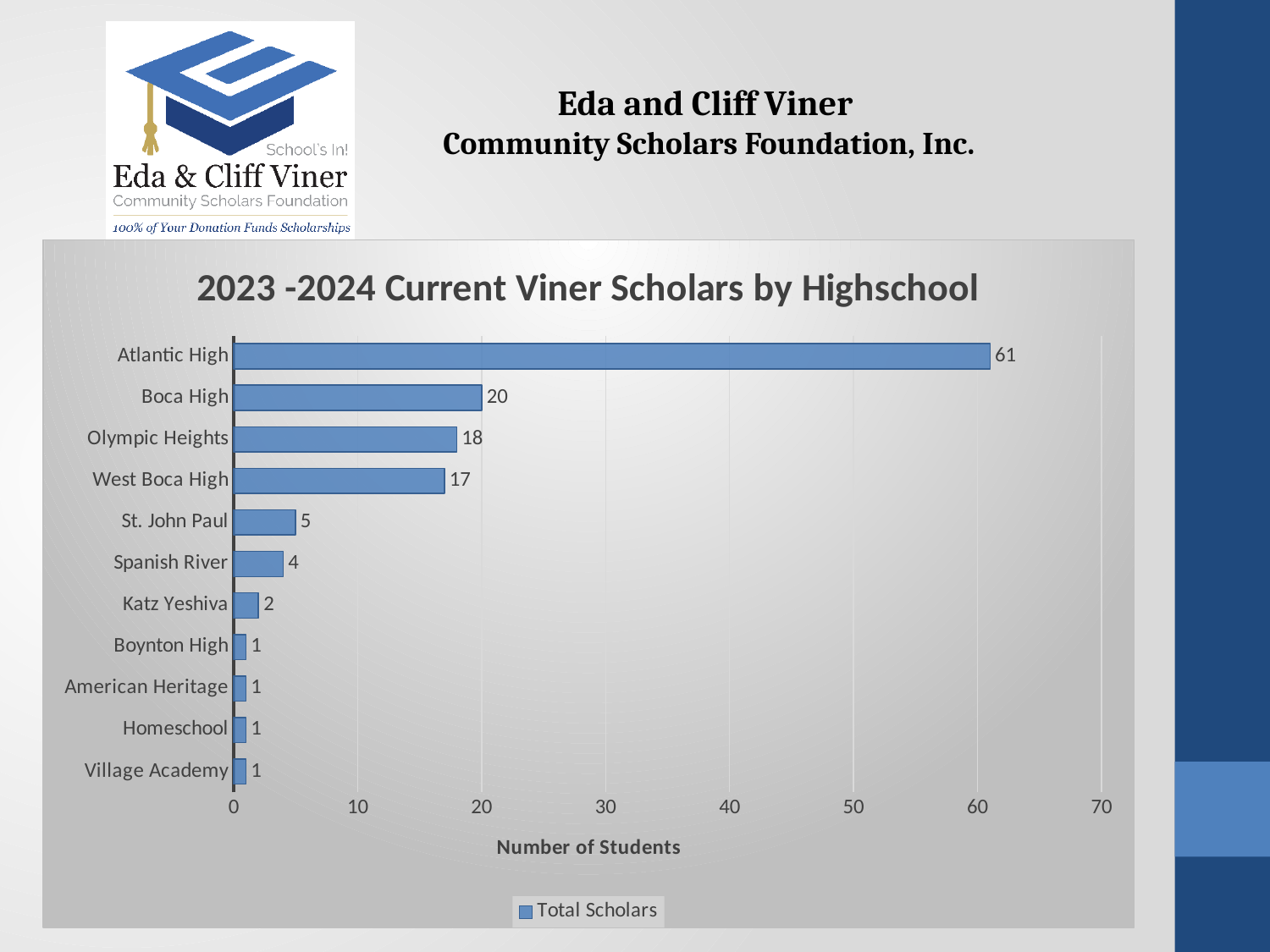
How many series does the legend list? 1 What is the title of the chart? 2023 -2024 Current Viner Scholars by Highschool Is the value for Atlantic High greater or less than 50? greater Which has more scholars, Spanish River or Katz Yeshiva? Spanish River How many scholars does the chart show for Atlantic High? 61 What is the label on the horizontal axis? Number of Students What is the difference between the values for Boca High and West Boca High? 3 How many high schools are listed on the chart? 11 How many students are shown for St. John Paul? 5 Which high school has the highest number of scholars? Atlantic High What kind of chart is shown on the slide? bar chart What is the value for Olympic Heights? 18